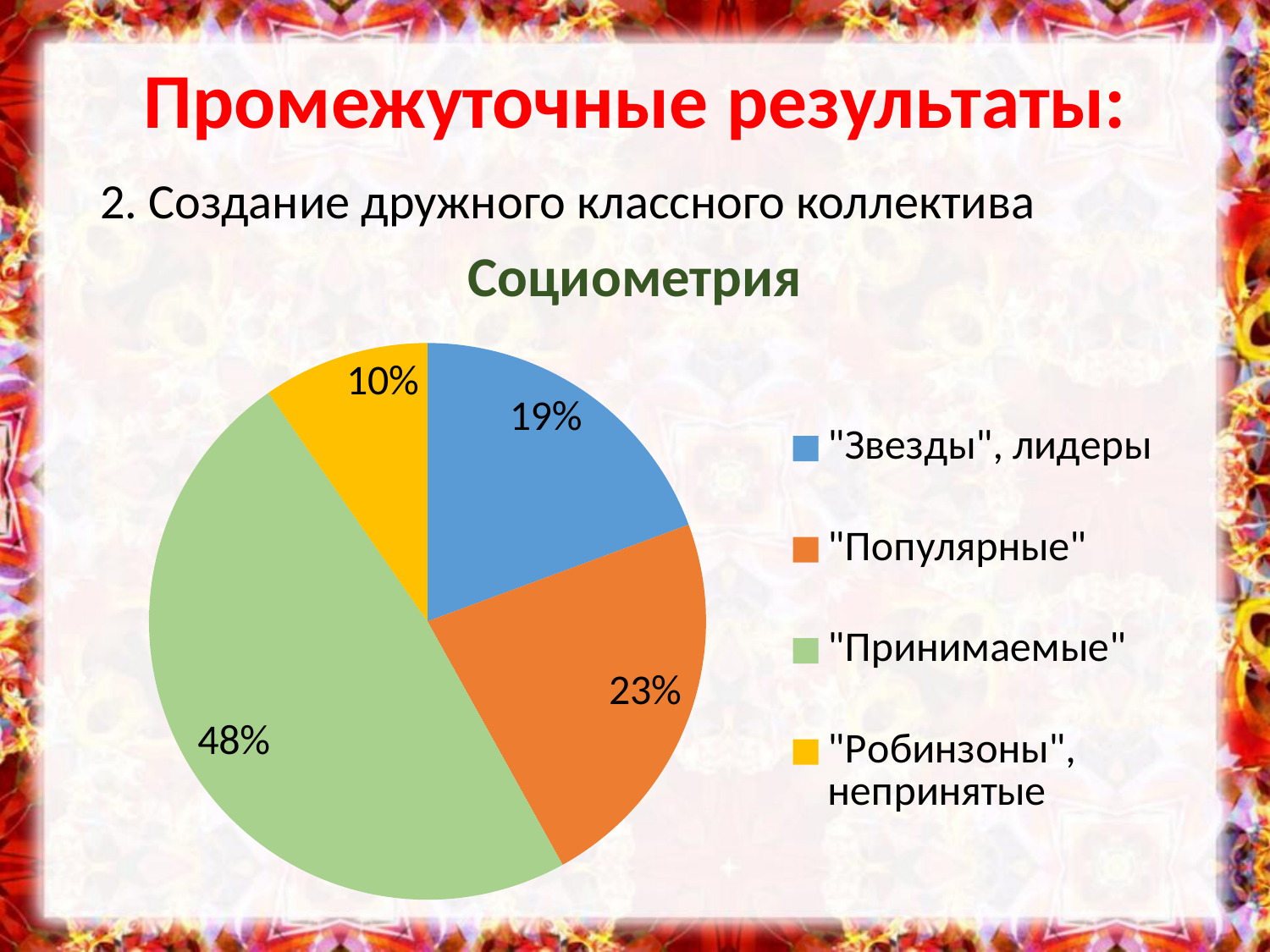
What share of the pie is labelled "Робинзоны", непринятые? 10% What share of the pie is labelled "Популярные"? 23% Which category has the smallest slice of the pie? "Робинзоны", непринятые Which is larger, the slice for "Популярные" or the slice for "Звезды", лидеры? "Популярные" Which category has the largest slice of the pie? "Принимаемые" How many slices does the pie chart have? 4 What colour is the slice for "Принимаемые"? green What kind of chart is shown on the slide? pie chart What is the title of the chart? Социометрия What share of the pie is labelled "Принимаемые"? 48% What is the difference in percentage points between "Принимаемые" and "Популярные"? 25 What share of the pie is labelled "Звезды", лидеры? 19%